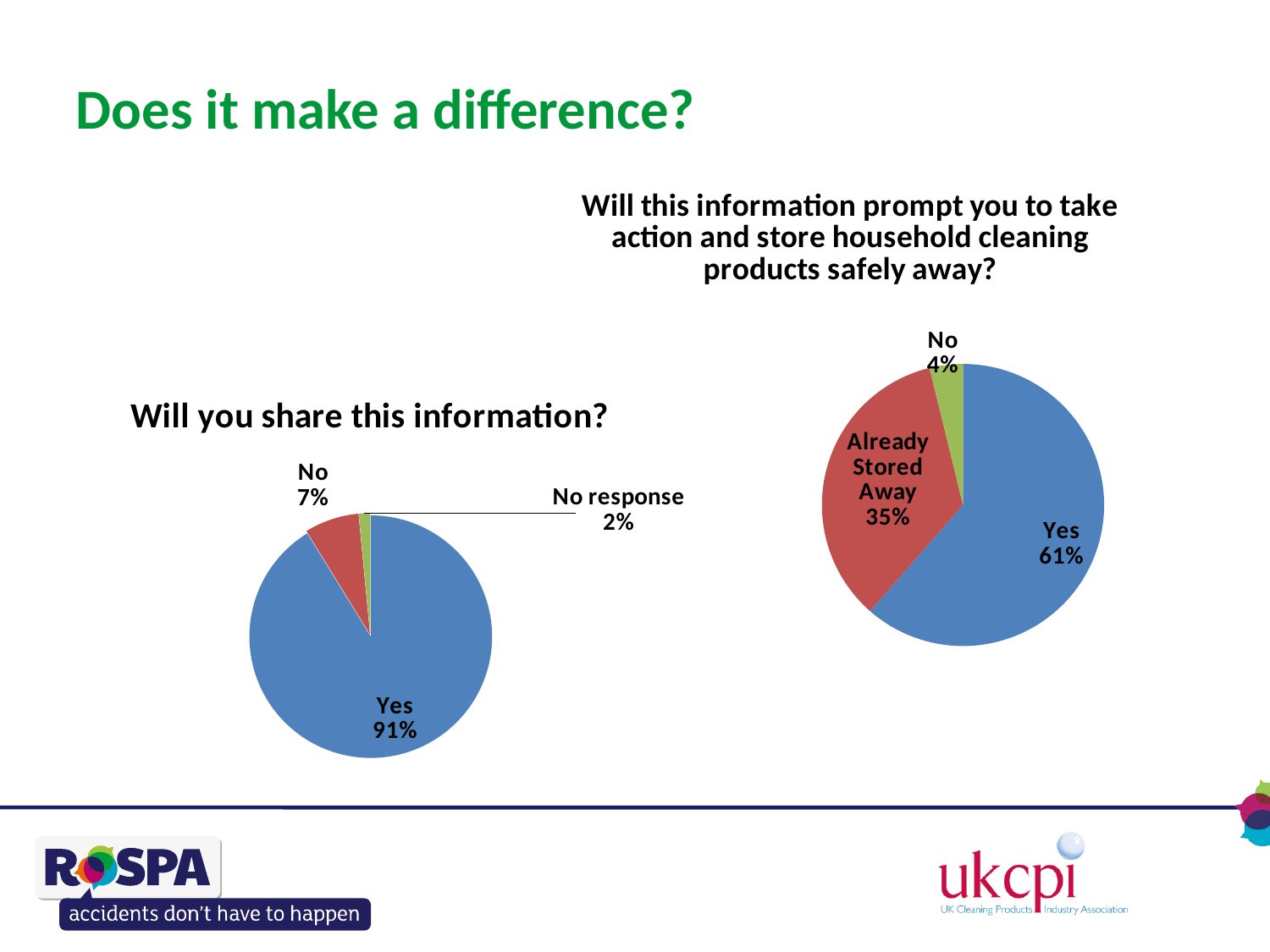
In the 'Will you share this information?' chart, what share is labelled No response? 2% In the 'Will this information prompt you to take action...' chart, which category has the smallest slice? No How many slices does the 'Will you share this information?' chart have? 3 In the 'Will this information prompt you to take action...' chart, what percentage answered No? 4% In the 'Will you share this information?' chart, which category has the largest slice? Yes In the 'Will this information prompt you to take action...' chart, what percentage is labelled Already Stored Away? 35% Which is larger: the Yes share in the 'Will you share this information?' chart or the Yes share in the 'Will this information prompt you to take action...' chart? Will you share this information? In the 'Will you share this information?' chart, what percentage answered Yes? 91% In the 'Will this information prompt you to take action...' chart, what is the difference between the Yes and Already Stored Away percentages? 26% In the 'Will this information prompt you to take action...' chart, what percentage answered Yes? 61% In the 'Will you share this information?' chart, what percentage answered No? 7% What type of chart is used on the right-hand side of the slide? Pie chart